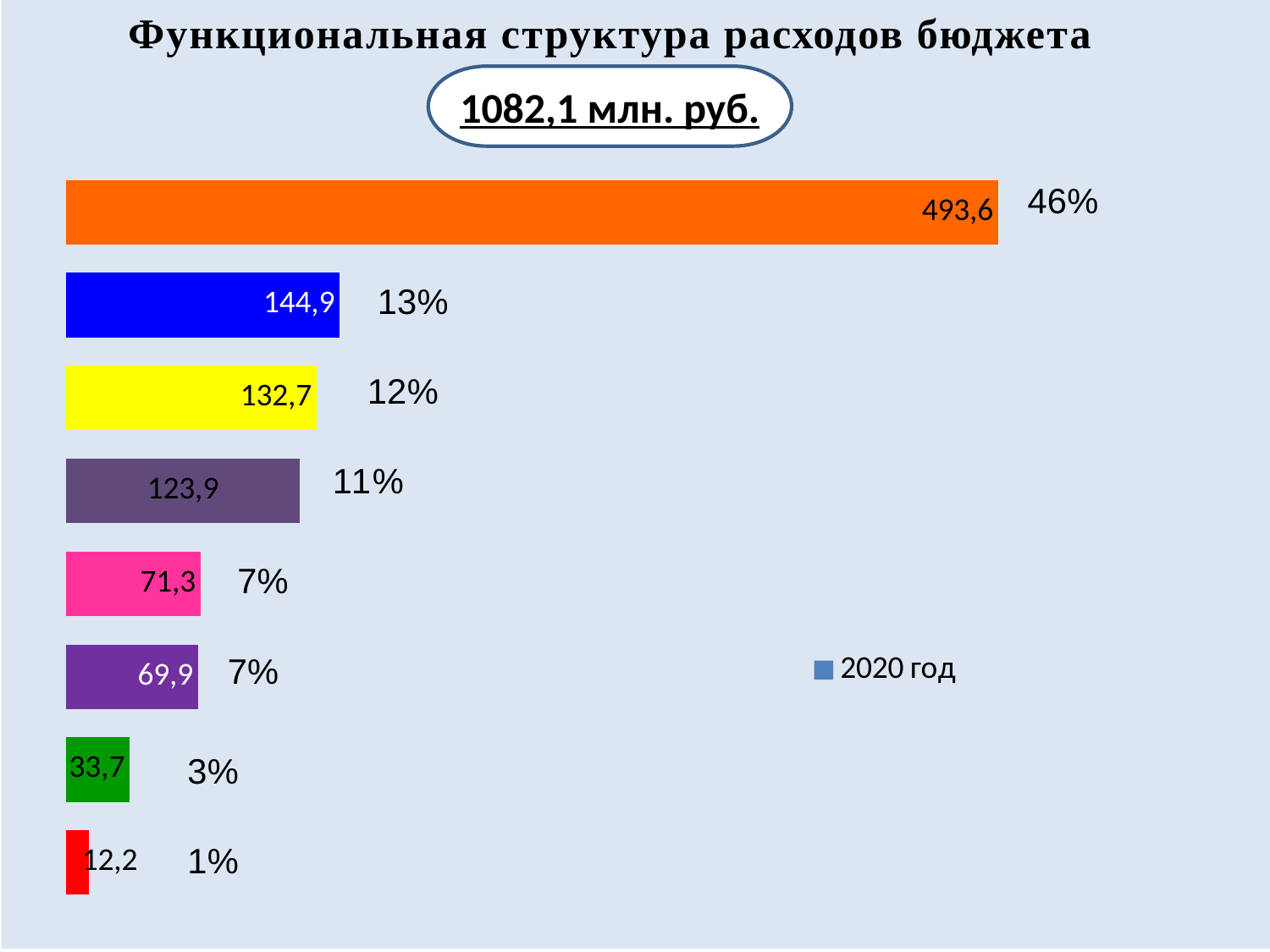
Which bar has the highest value? the orange (top) bar, 493,6 How many bars are plotted in the chart? 8 What type of chart is shown on the slide? bar chart Which is larger, the value of the pink bar or the value of the purple bar? the pink bar (71,3) What percentage is shown next to the yellow bar? 12% What is the difference between the values of the blue bar and the yellow bar? 12,2 What is the value printed on the blue bar? 144,9 What is the value printed on the green bar? 33,7 What series name is shown in the legend? 2020 год How many series does the legend list? 1 Which bar has the lowest value? the red (bottom) bar, 12,2 What is the value printed on the orange (top) bar? 493,6